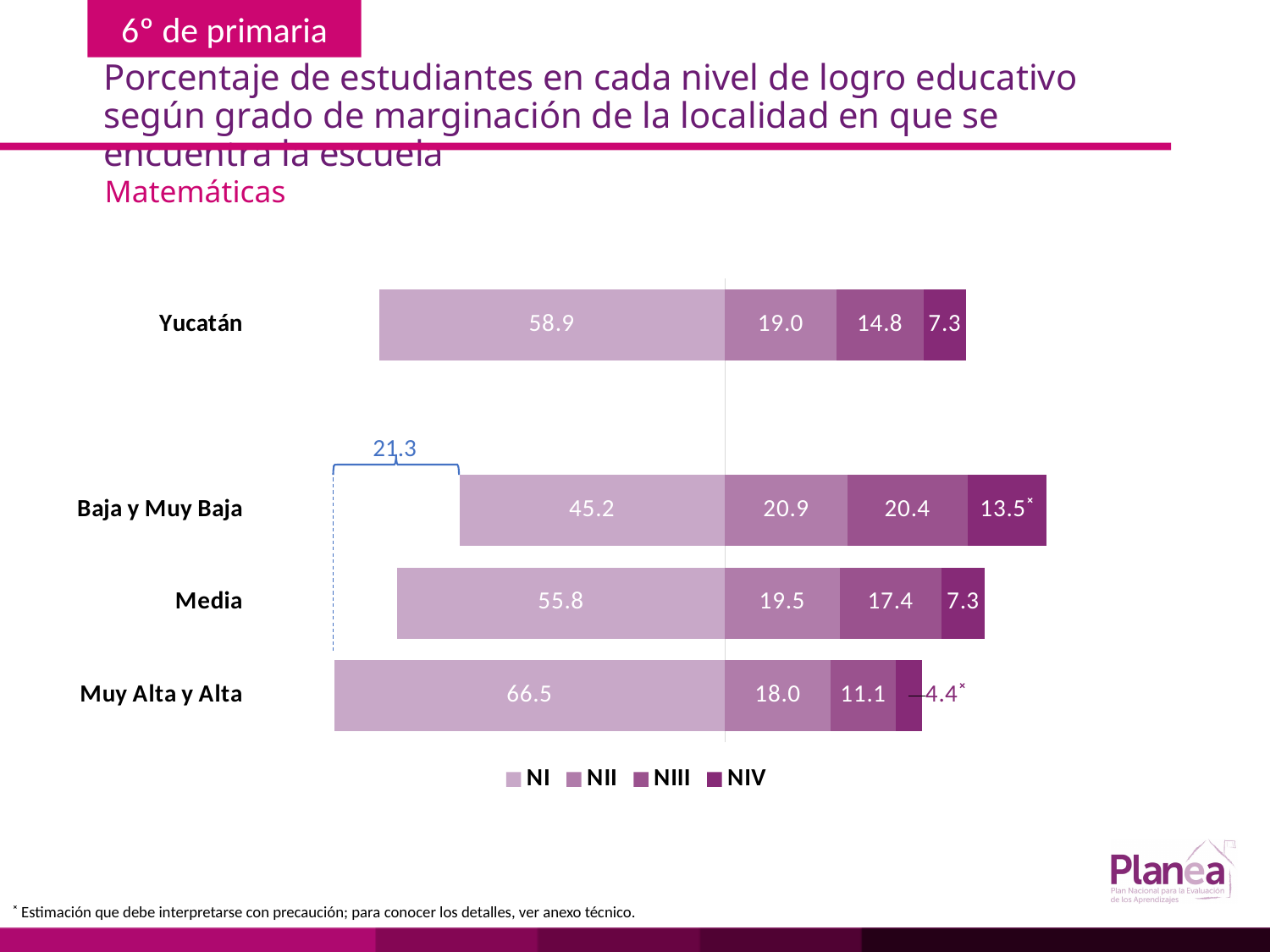
How many series does the legend list? 4 What is the NIV value for Baja y Muy Baja? 13.5 What kind of chart is shown on the slide? Stacked bar chart What is the NI value for Yucatán? 58.9 Which category has the highest NI value? Muy Alta y Alta Which has the larger NIII value, Baja y Muy Baja or Media? Baja y Muy Baja What is the difference between the NI value for Muy Alta y Alta and the NI value for Baja y Muy Baja? 21.3 How many categories are shown on the chart? 4 What is the total of the stacked bar for Yucatán? 100.0 Which category has the lowest NIV value? Muy Alta y Alta What is the NII value for Media? 19.5 What is the NIII value for Muy Alta y Alta? 11.1